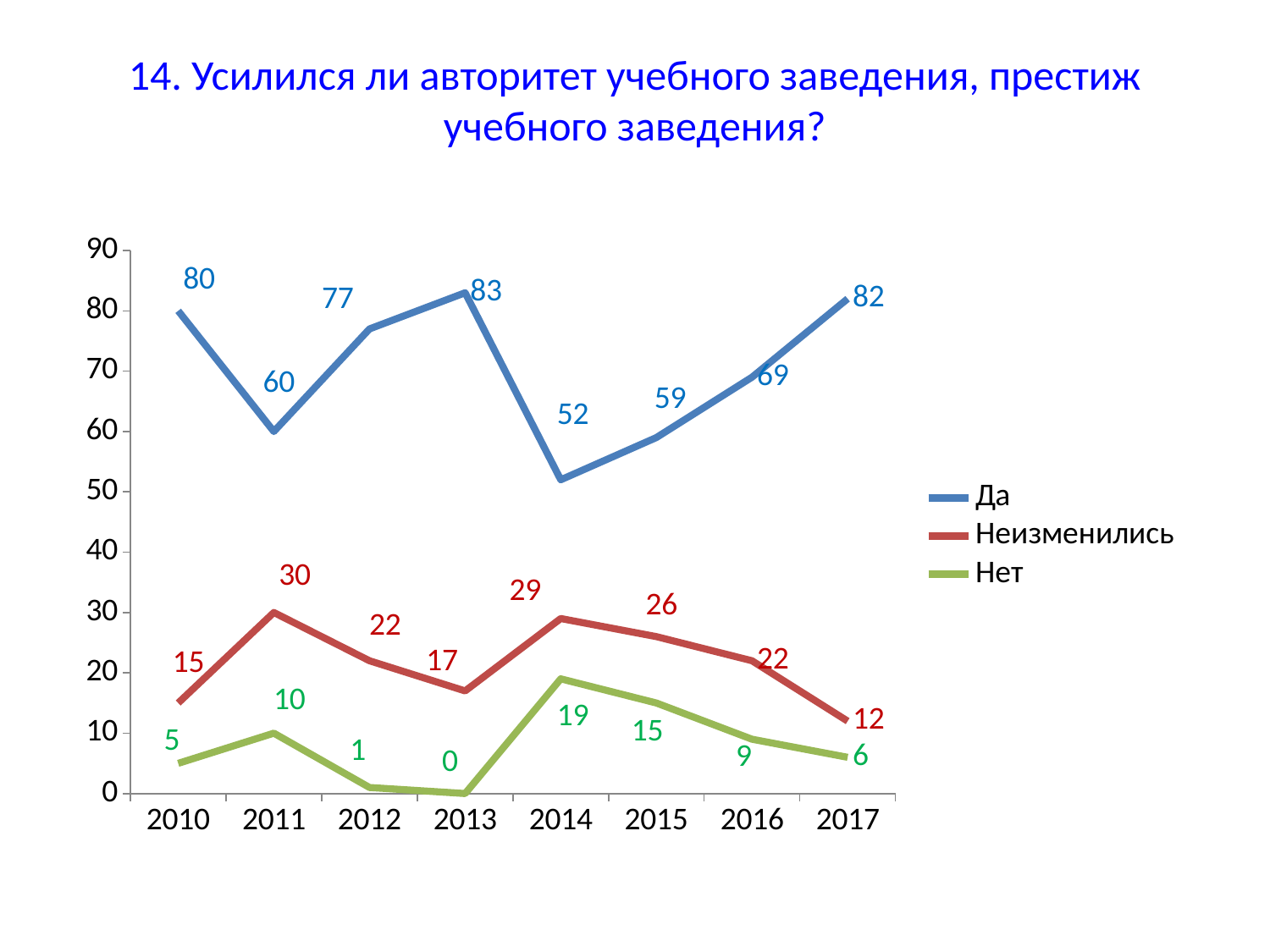
What is the value for Нет in 2014? 19 In which year is the value for Да lowest? 2014 What is the value for Да in 2013? 83 How many series does the legend list? 3 Which colour is used for the Нет series? green How many years are shown on the x axis? 8 Does the value for Да rise or fall from 2014 to 2017? rise What is the difference between the Да values in 2013 and 2014? 31 In which year is the value for Нет highest? 2014 What type of chart is shown on the slide? line chart What is the value for Неизменились in 2011? 30 Which is larger: Неизменились in 2014 or Неизменились in 2017? Неизменились in 2014